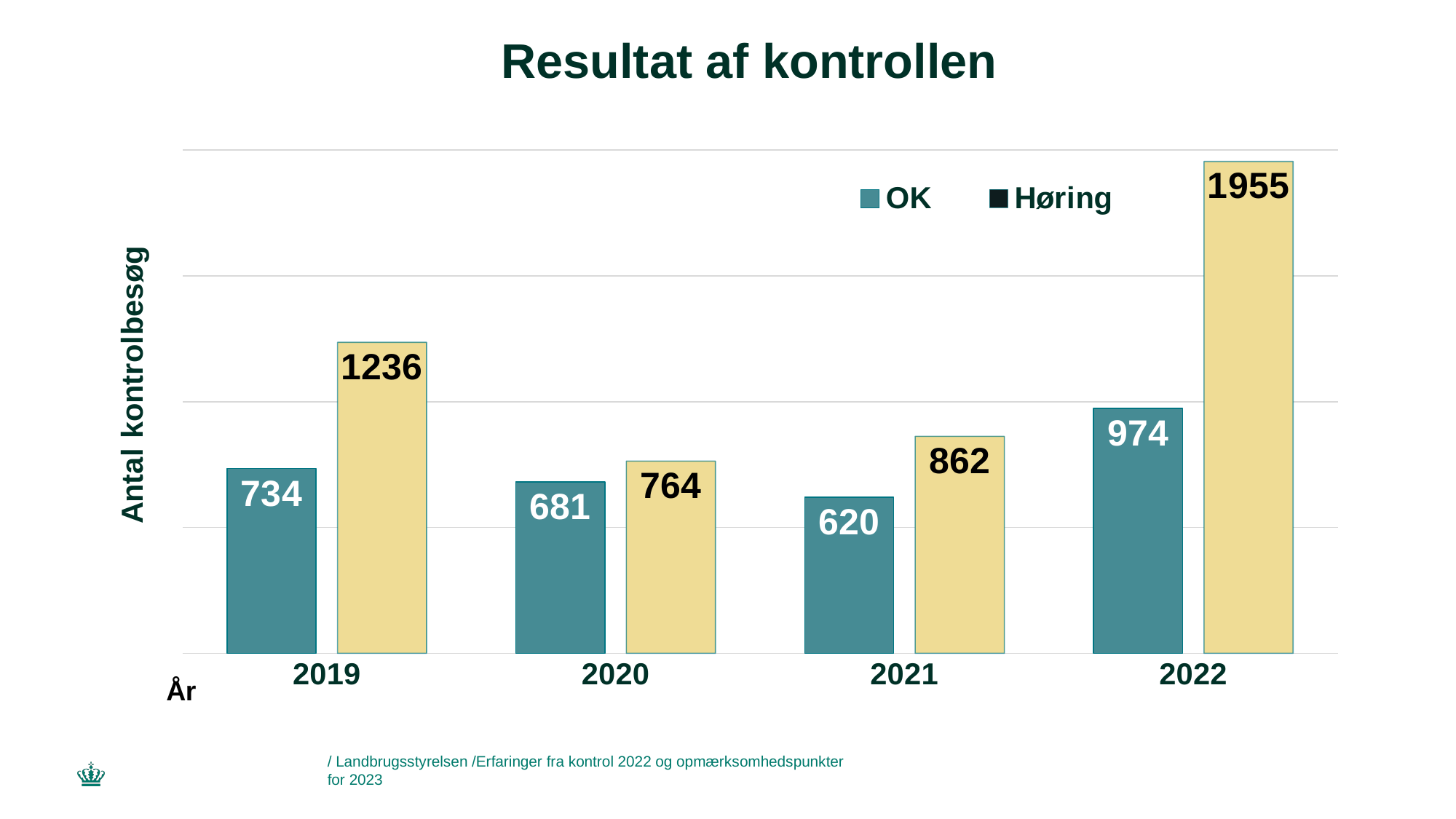
What is the Høring value for 2022? 1955 Which is larger in 2020, the OK value or the Høring value? Høring What kind of chart is shown on the slide? Bar chart How many years are shown on the x axis? 4 What is the difference between the Høring and OK values in 2022? 981 What is the Høring value for 2020? 764 What is the OK value for 2021? 620 Which year has the lowest OK value? 2021 How many series does the legend list? 2 What is the title of the chart? Resultat af kontrollen What is the OK value for 2019? 734 Which year has the highest Høring value? 2022